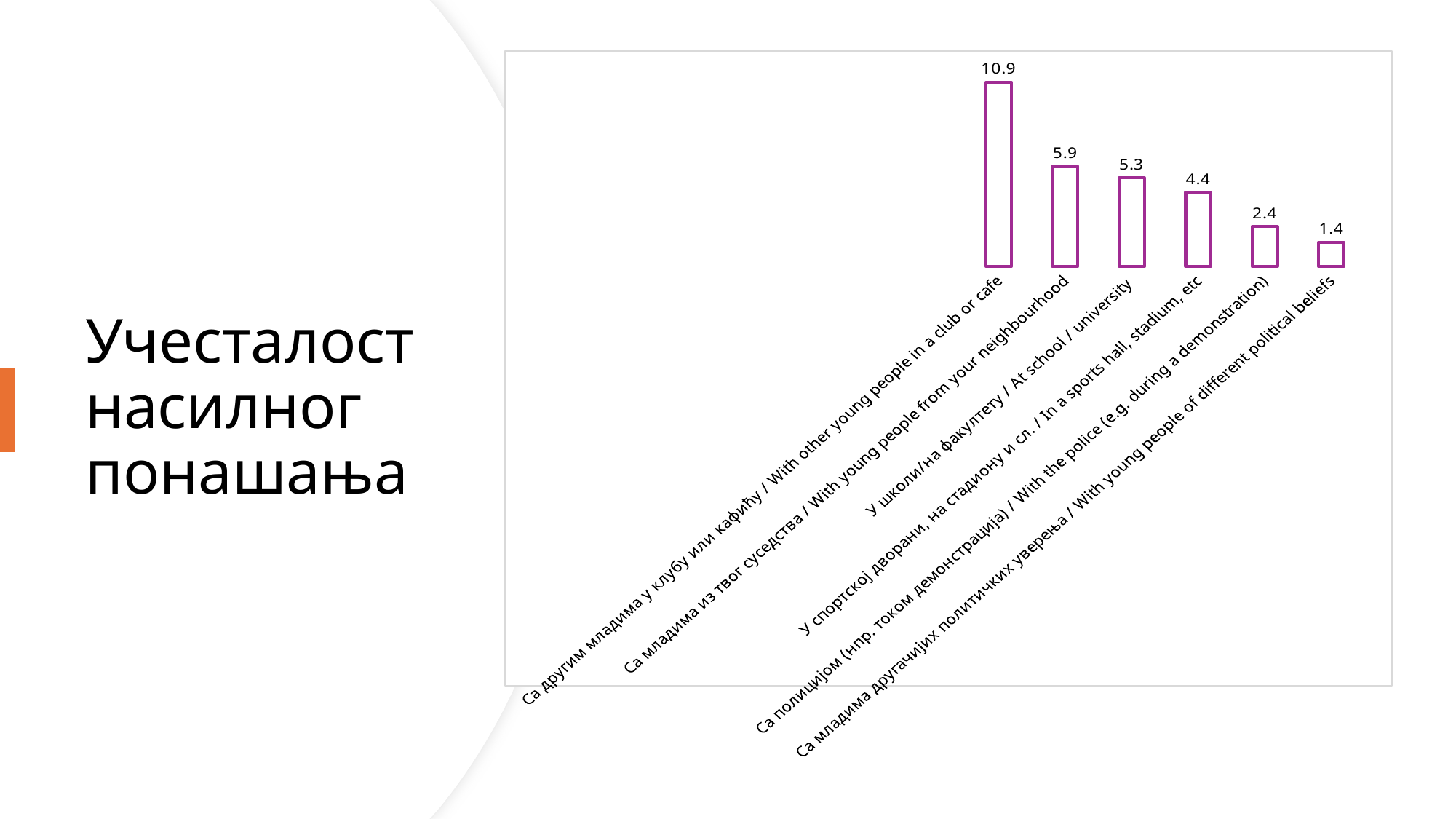
What is the value for 'With young people from your neighbourhood'? 5.9 What is the value for 'In a sports hall, stadium, etc'? 4.4 What is the value for 'With other young people in a club or cafe'? 10.9 How many categories are shown in the chart? 6 What is the value for 'With the police (e.g. during a demonstration)'? 2.4 Which is larger: the value for 'At school / university' or the value for 'In a sports hall, stadium, etc'? At school / university What is the value for 'With young people of different political beliefs'? 1.4 What kind of chart is shown on the slide? Bar chart Which category has the lowest value? With young people of different political beliefs Which category has the highest value? With other young people in a club or cafe What is the value for 'At school / university'? 5.3 What is the difference between the values for 'With other young people in a club or cafe' and 'With young people from your neighbourhood'? 5.0